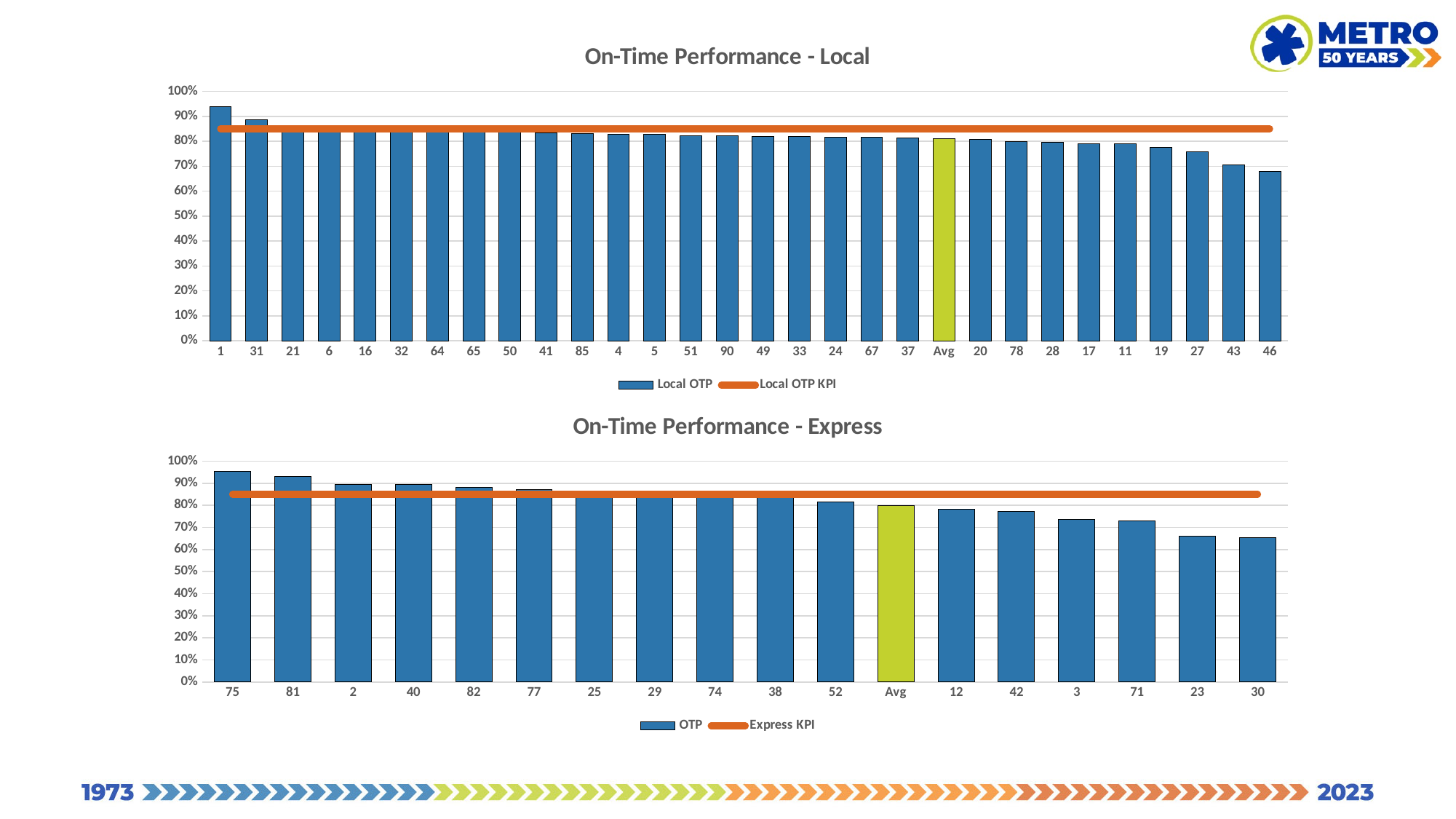
On the On-Time Performance - Express chart, how many categories are shown on the x axis? 18 On the On-Time Performance - Express chart, what are the two legend entries? OTP and Express KPI On the On-Time Performance - Local chart, is the value for route 1 greater or less than 90%? greater On the On-Time Performance - Local chart, what kind of chart is used to show the Local OTP values? bar chart On the On-Time Performance - Local chart, do the bar values rise or fall from left to right along the x axis? fall On the On-Time Performance - Express chart, which is larger, the value for route 81 or the value for route 23? 81 On the On-Time Performance - Express chart, is the value for route 30 greater or less than 70%? less On the On-Time Performance - Express chart, which route has the highest on-time performance? 75 On the On-Time Performance - Local chart, how many categories are shown on the x axis? 30 On the On-Time Performance - Local chart, which route has the highest on-time performance? 1 On the On-Time Performance - Local chart, which route has the lowest on-time performance? 46 On the On-Time Performance - Local chart, how many series does the legend list? 2